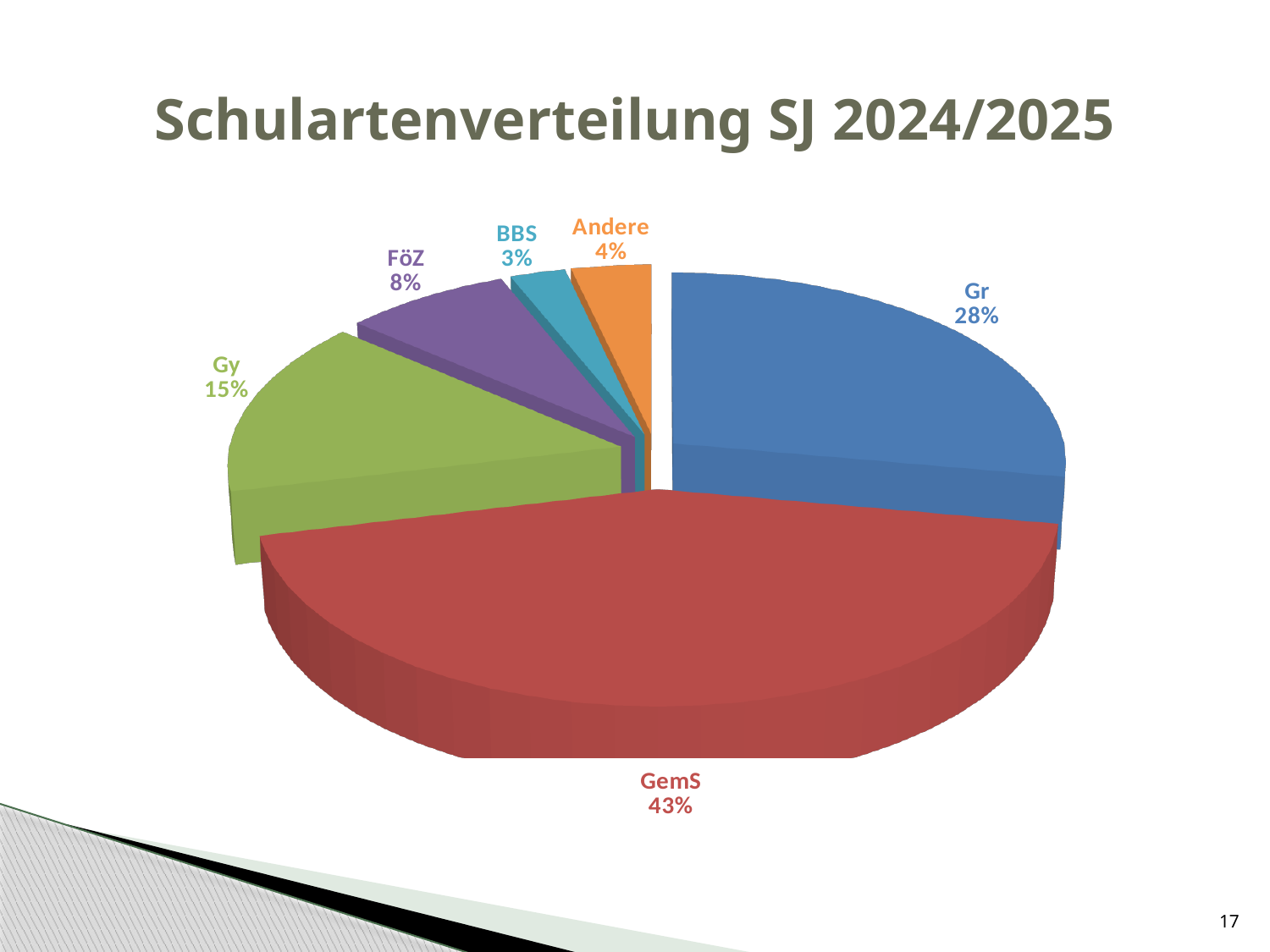
How many slices does the pie chart have? 6 What kind of chart is shown on the slide? pie chart What is the value shown for Gr? 28% Which category has the largest slice of the pie? GemS What colour is the GemS slice? red Which is larger, the slice for Andere or the slice for BBS? Andere What share of the pie does GemS have? 43% What is the title of the chart? Schulartenverteilung SJ 2024/2025 Which category has the smallest slice of the pie? BBS What is the difference in percentage points between GemS and Gr? 15 What is the value shown for Gy? 15% What is the value shown for FöZ? 8%